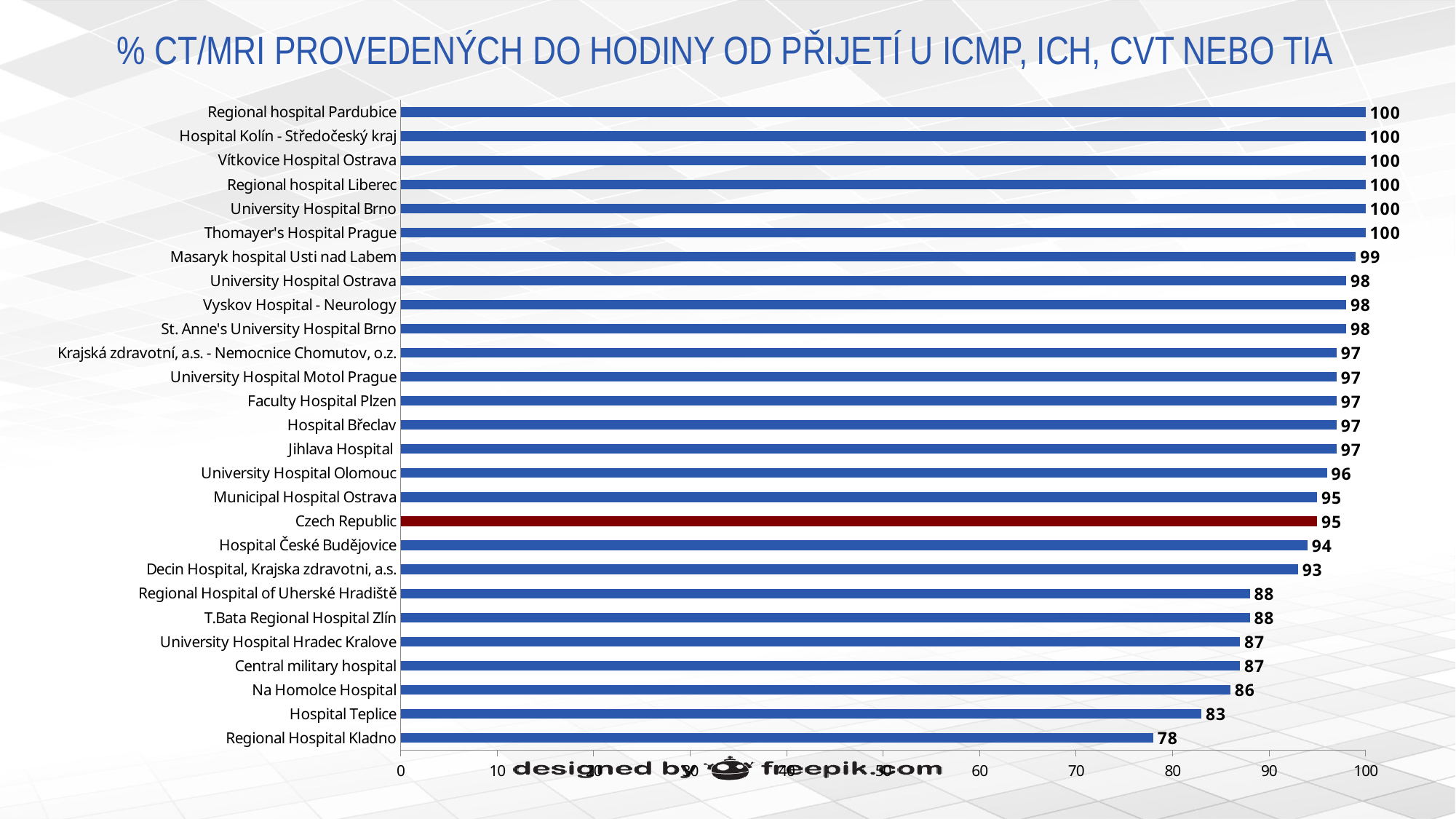
What is the value for Czech Republic? 95 Which hospital has the lowest value? Regional Hospital Kladno Which is larger, the value for Hospital České Budějovice or the value for T.Bata Regional Hospital Zlín? Hospital České Budějovice What is the difference between the values for Czech Republic and Regional Hospital Kladno? 17 What is the value for Hospital Teplice? 83 What is the highest value shown on the chart? 100 How many hospitals/categories are shown on the chart? 27 What is the difference between the values for University Hospital Olomouc and Na Homolce Hospital? 10 What is the value for Masaryk hospital Usti nad Labem? 99 Which bar is highlighted in a different colour (dark red) from the others? Czech Republic What kind of chart is shown on the slide? Bar chart What is the value for Regional Hospital Kladno? 78